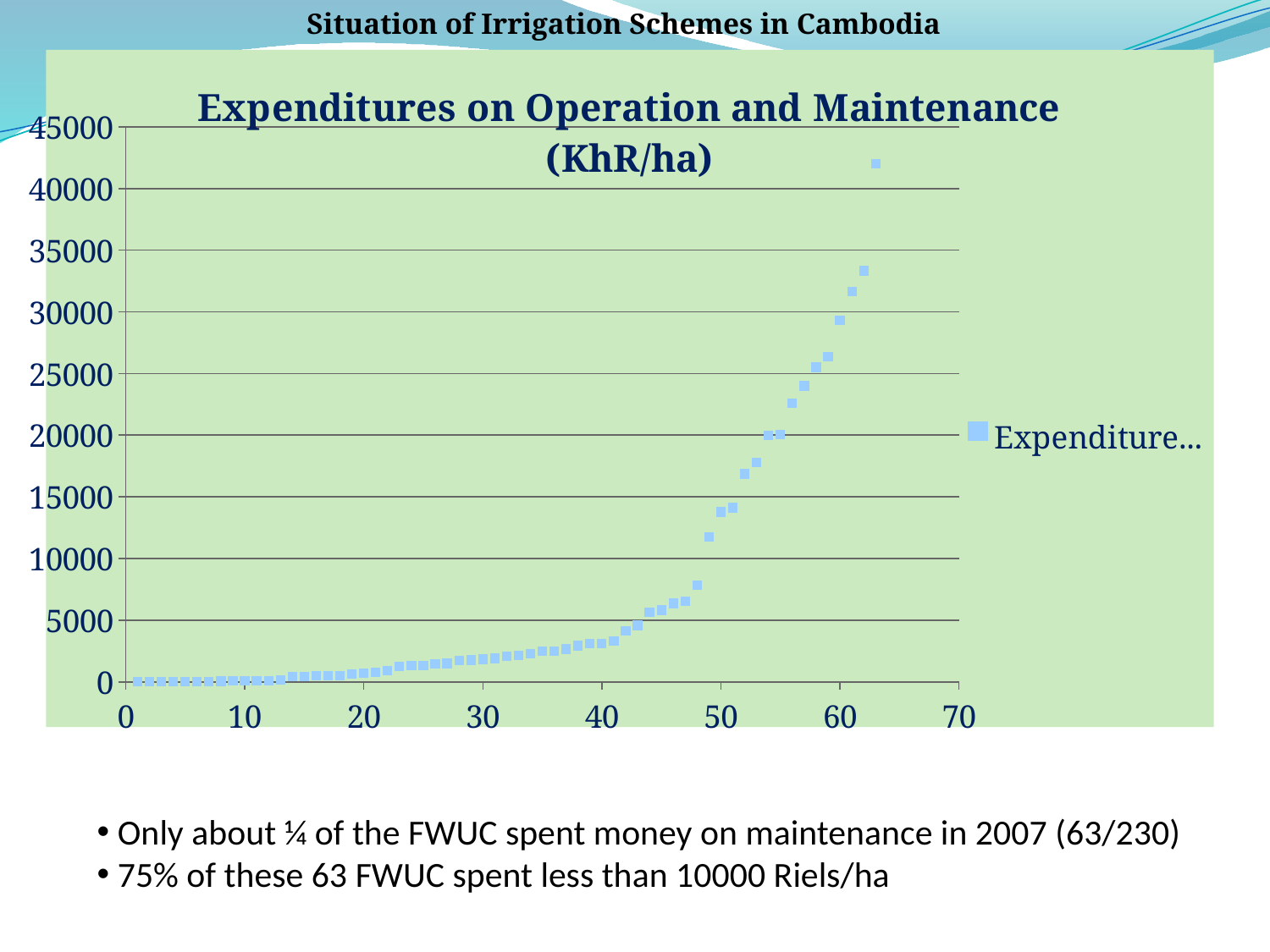
Is the value of the plotted point at x = 61 greater or less than 30000? greater How many series does the chart legend list? 1 Is the value of the plotted point at x = 10 greater or less than 5000? less Is the value of the plotted point at x = 40 greater or less than 5000? less How many FWUC data points are plotted on the chart, according to the slide? 63 What is the maximum value shown on the chart's y axis? 45000 Do the plotted expenditure values rise or fall as you move from left to right along the x axis? rise What kind of chart is shown on the slide? scatter chart What is the title of the chart? Expenditures on Operation and Maintenance (KhR/ha)